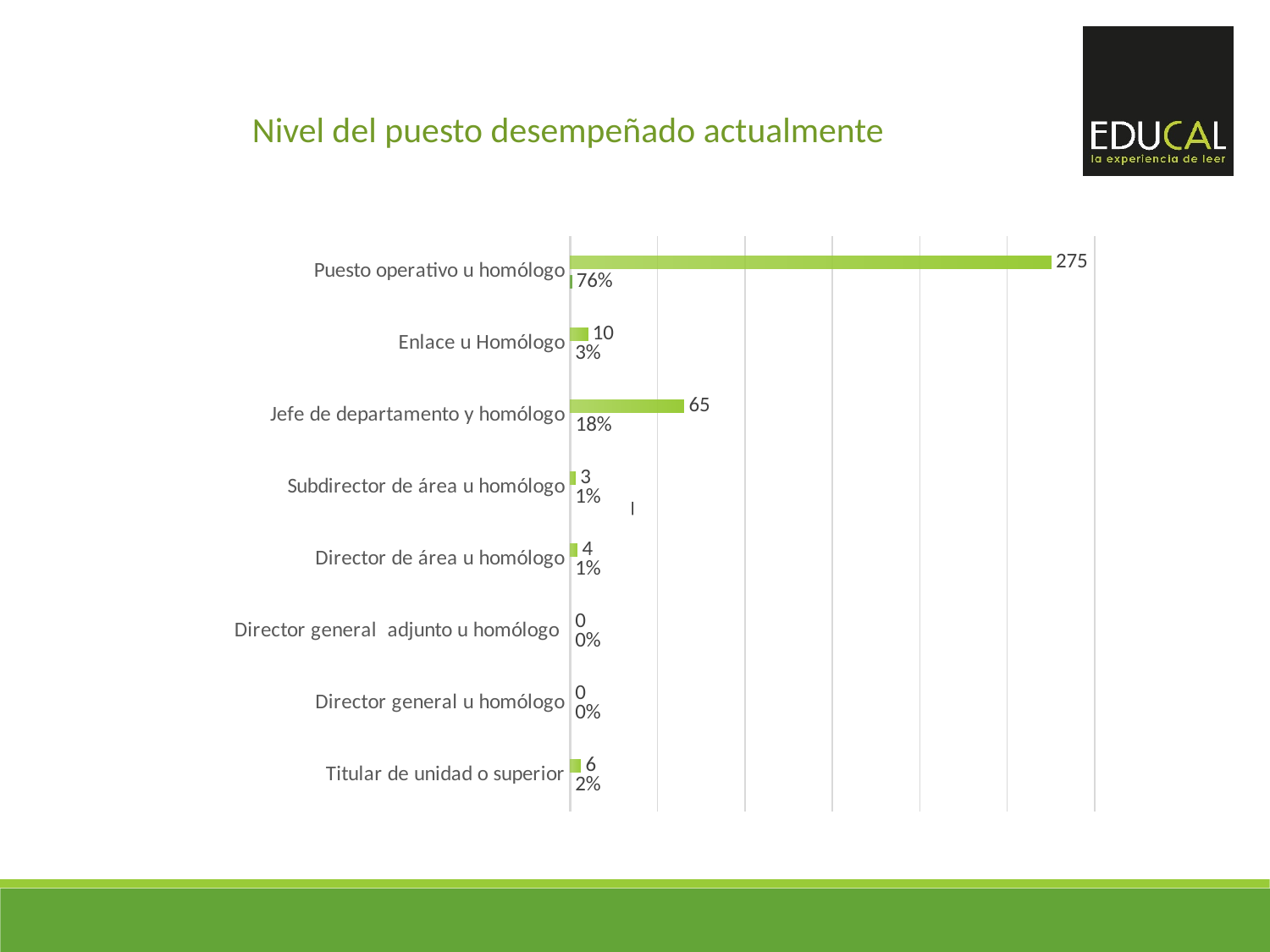
What percentage is shown for Titular de unidad o superior? 2% Which category has the highest count? Puesto operativo u homólogo Which has a larger count, Director de área u homólogo or Subdirector de área u homólogo? Director de área u homólogo How many categories are shown on the chart? 8 What is the count value for Puesto operativo u homólogo? 275 What percentage is shown for Jefe de departamento y homólogo? 18% What is the count value for Enlace u Homólogo? 10 What is the difference between the counts for Puesto operativo u homólogo and Jefe de departamento y homólogo? 210 What is the count value for Director general u homólogo? 0 What is the difference between the counts for Titular de unidad o superior and Director de área u homólogo? 2 What kind of chart is shown on the slide? Bar chart What is the title of the chart? Nivel del puesto desempeñado actualmente